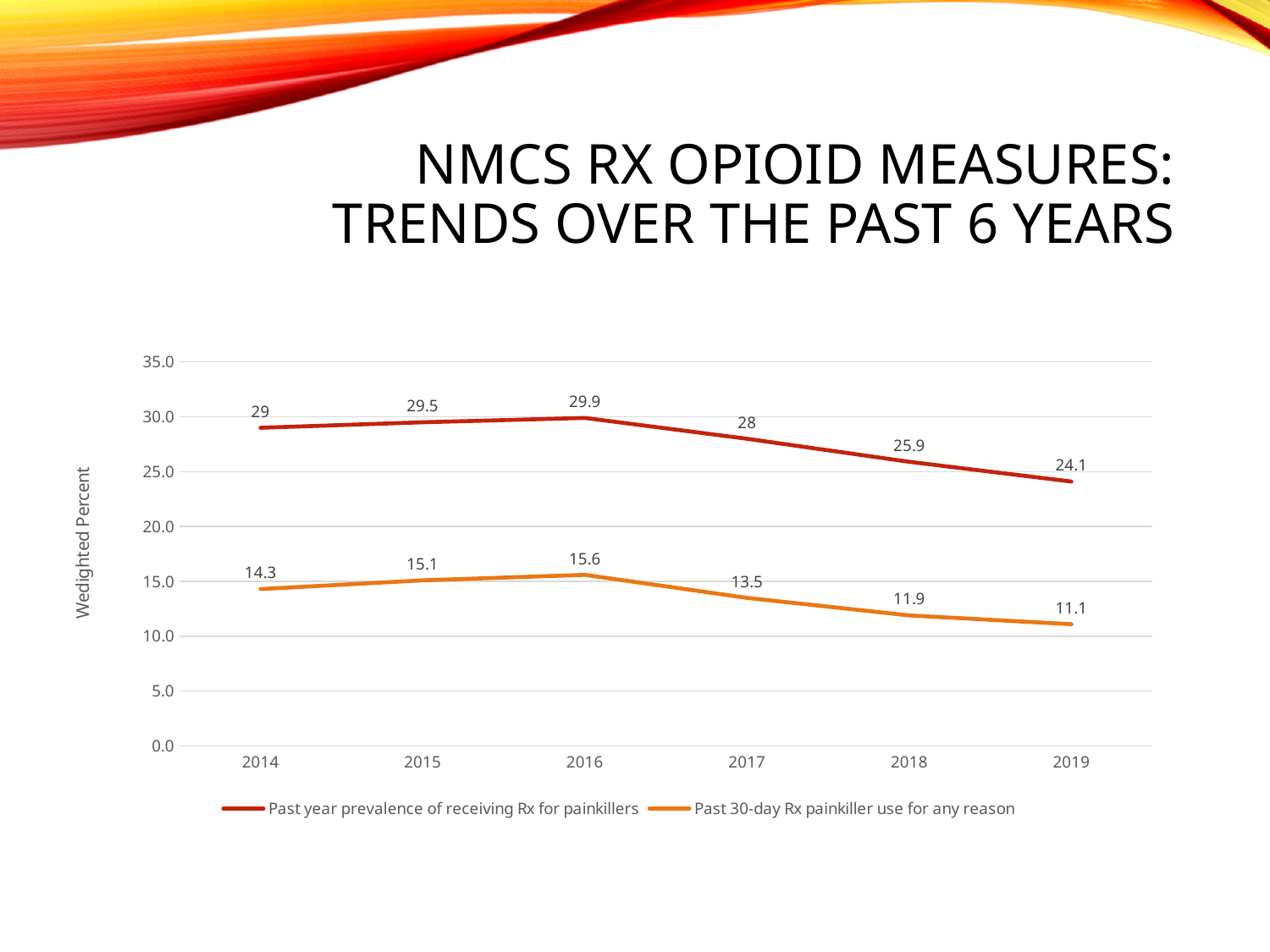
In which year is 'Past 30-day Rx painkiller use for any reason' lowest? 2019 Is the value for 'Past year prevalence of receiving Rx for painkillers' in 2018 greater or less than 25.0? greater In which year is 'Past year prevalence of receiving Rx for painkillers' highest? 2016 What is the label of the y axis? Wedighted Percent What is the value for 'Past year prevalence of receiving Rx for painkillers' in 2016? 29.9 How many years are shown on the x axis? 6 Which is larger: 'Past 30-day Rx painkiller use for any reason' in 2015 or in 2018? 2015 What is the difference between the 'Past year prevalence of receiving Rx for painkillers' values in 2016 and 2019? 5.8 From 2016 to 2019, do the values for 'Past 30-day Rx painkiller use for any reason' rise or fall? fall What is the value for 'Past 30-day Rx painkiller use for any reason' in 2019? 11.1 How many series does the legend list? 2 What type of chart is shown on the slide? line chart